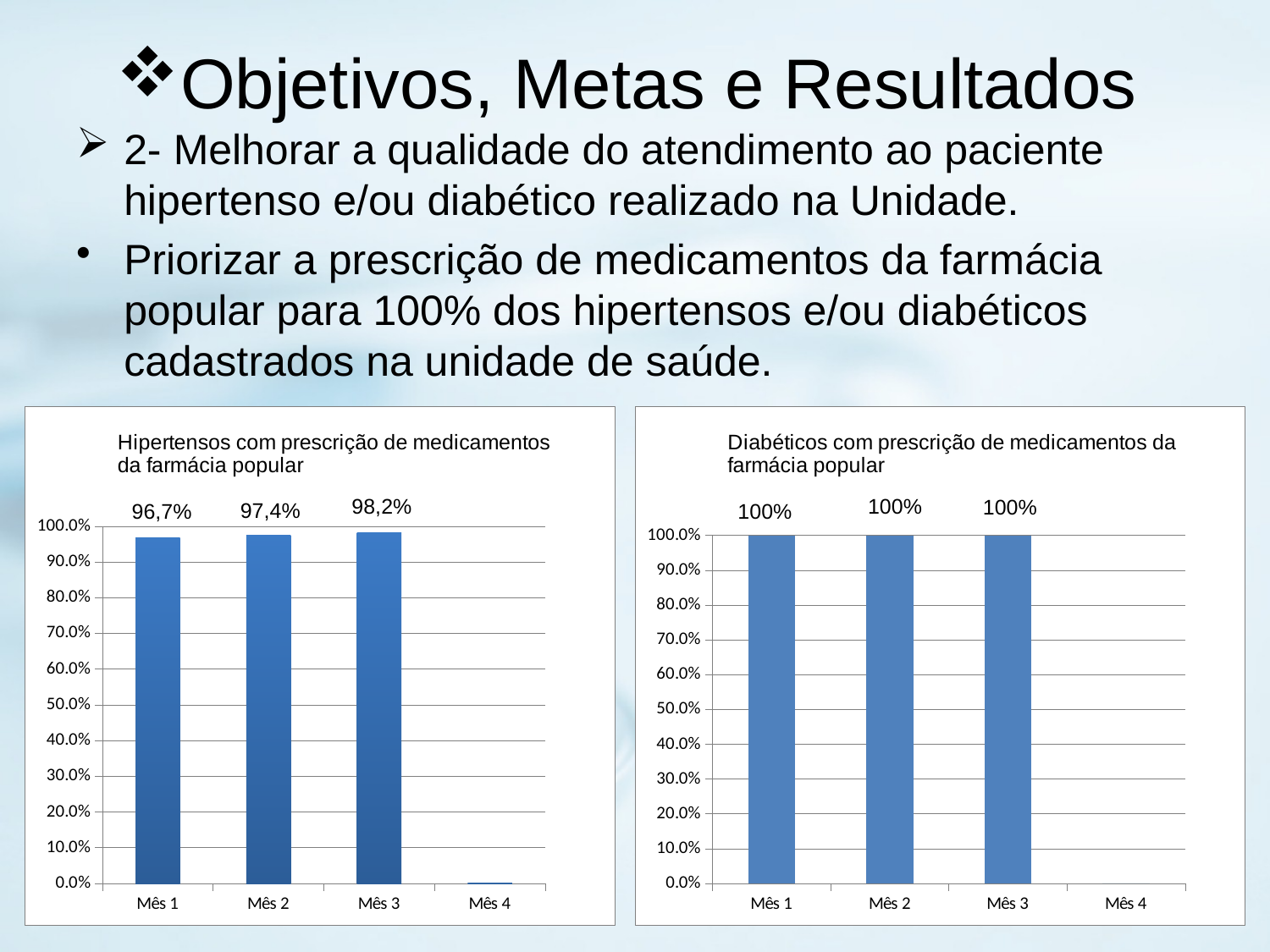
What kind of chart is the left chart (Hipertensos com prescrição de medicamentos da farmácia popular)? Bar chart In the left chart (Hipertensos com prescrição de medicamentos da farmácia popular), is the value for Mês 4 greater or less than 10.0%? less In the left chart (Hipertensos com prescrição de medicamentos da farmácia popular), what is the value for Mês 1? 96,7% How many month categories are shown on the x axis of the right chart (Diabéticos com prescrição de medicamentos da farmácia popular)? 4 In the left chart (Hipertensos com prescrição de medicamentos da farmácia popular), which month has the highest value? Mês 3 In the left chart (Hipertensos com prescrição de medicamentos da farmácia popular), which month has the lowest value? Mês 4 In the left chart (Hipertensos com prescrição de medicamentos da farmácia popular), what is the value for Mês 3? 98,2% In the left chart (Hipertensos com prescrição de medicamentos da farmácia popular), do the values rise or fall from Mês 1 to Mês 3? Rise In the right chart (Diabéticos com prescrição de medicamentos da farmácia popular), what is the value for Mês 2? 100% What is the title of the right chart? Diabéticos com prescrição de medicamentos da farmácia popular In the left chart (Hipertensos com prescrição de medicamentos da farmácia popular), what is the difference between the values for Mês 3 and Mês 1? 1,5% In the left chart (Hipertensos com prescrição de medicamentos da farmácia popular), which is larger, the value for Mês 2 or Mês 3? Mês 3